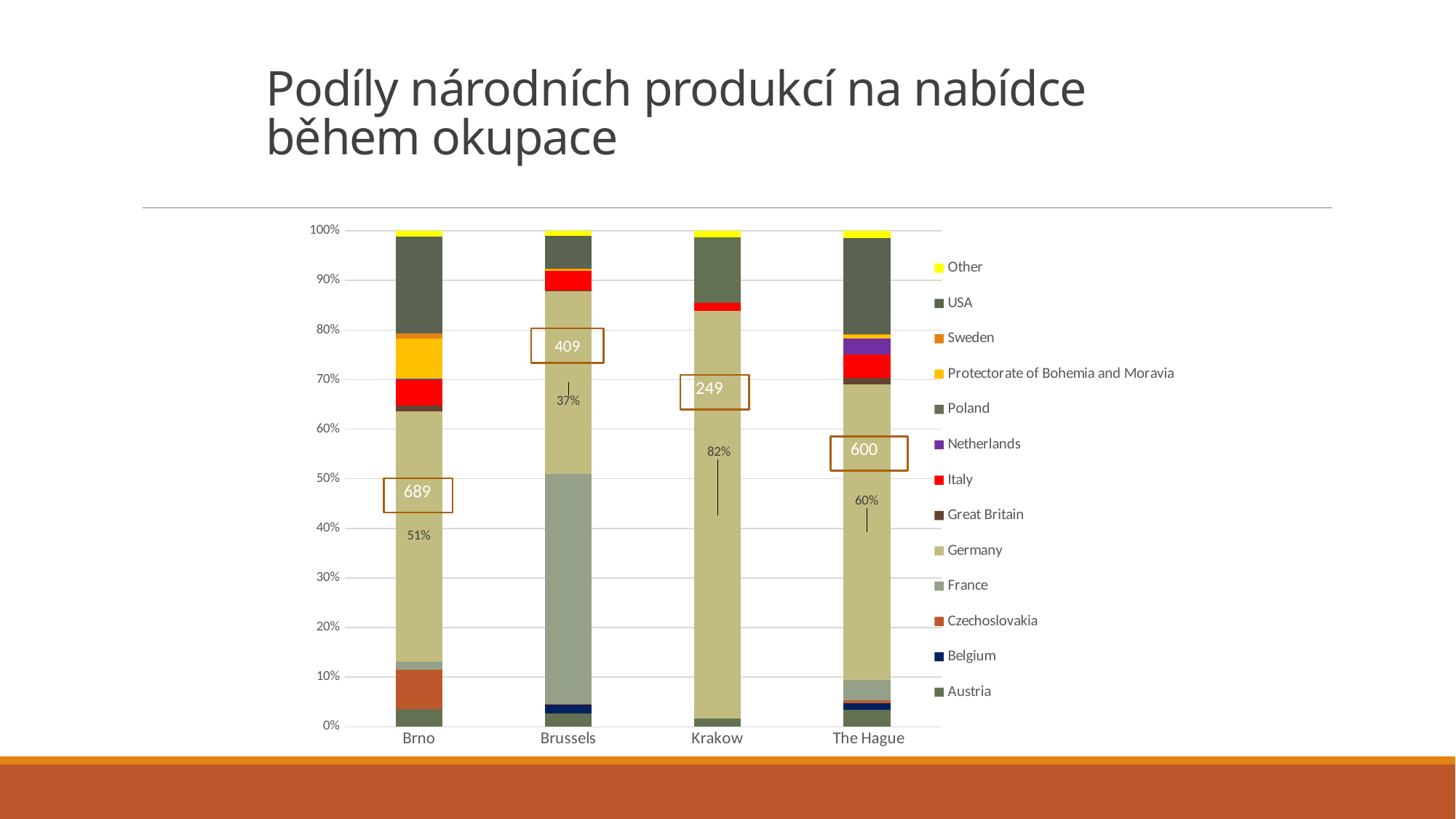
Which has a larger labelled Germany share, Brno or The Hague? The Hague What is the labelled share of Germany in the Brno bar? 51% What is the difference between the labelled Germany share in Krakow and in Brussels? 45% Which city has the highest labelled share for Germany? Krakow Is the France segment in the Brussels bar greater or less than 40%? greater How many series does the chart's legend list? 13 Which city has the lowest labelled share for Germany? Brussels What is the labelled share of Germany in the Brussels bar? 37% What number is shown in the box on the Brussels bar? 409 How many cities are shown on the x axis of the chart? 4 What is the labelled share of Germany in the Krakow bar? 82% What kind of chart is shown on the slide? stacked bar chart